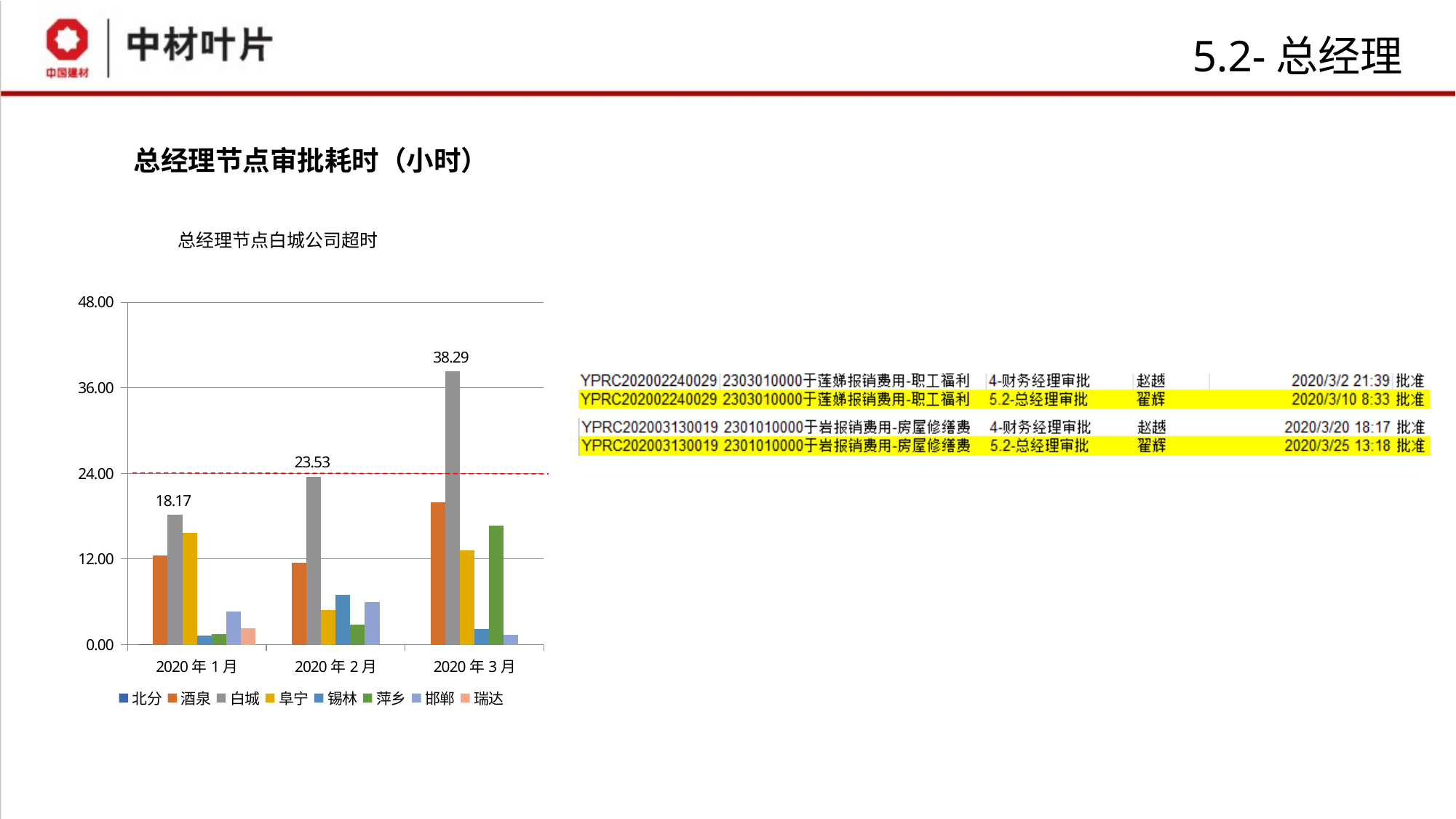
In which month is the value for 白城 the highest? 2020年3月 How many months are shown on the x axis? 3 Which is larger, the 白城 value for 2020年2月 or for 2020年3月? 2020年3月 What is the value for 白城 in 2020年1月? 18.17 How many series does the legend list? 8 Do the values for 白城 rise or fall from 2020年1月 to 2020年3月? rise Is the value for 萍乡 in 2020年3月 greater or less than 12.00? greater Is the value for 酒泉 in 2020年3月 greater or less than 24.00? less What kind of chart is shown on the slide? bar chart What is the value for 白城 in 2020年2月? 23.53 What is the difference between the 白城 values for 2020年3月 and 2020年1月? 20.12 What is the value for 白城 in 2020年3月? 38.29